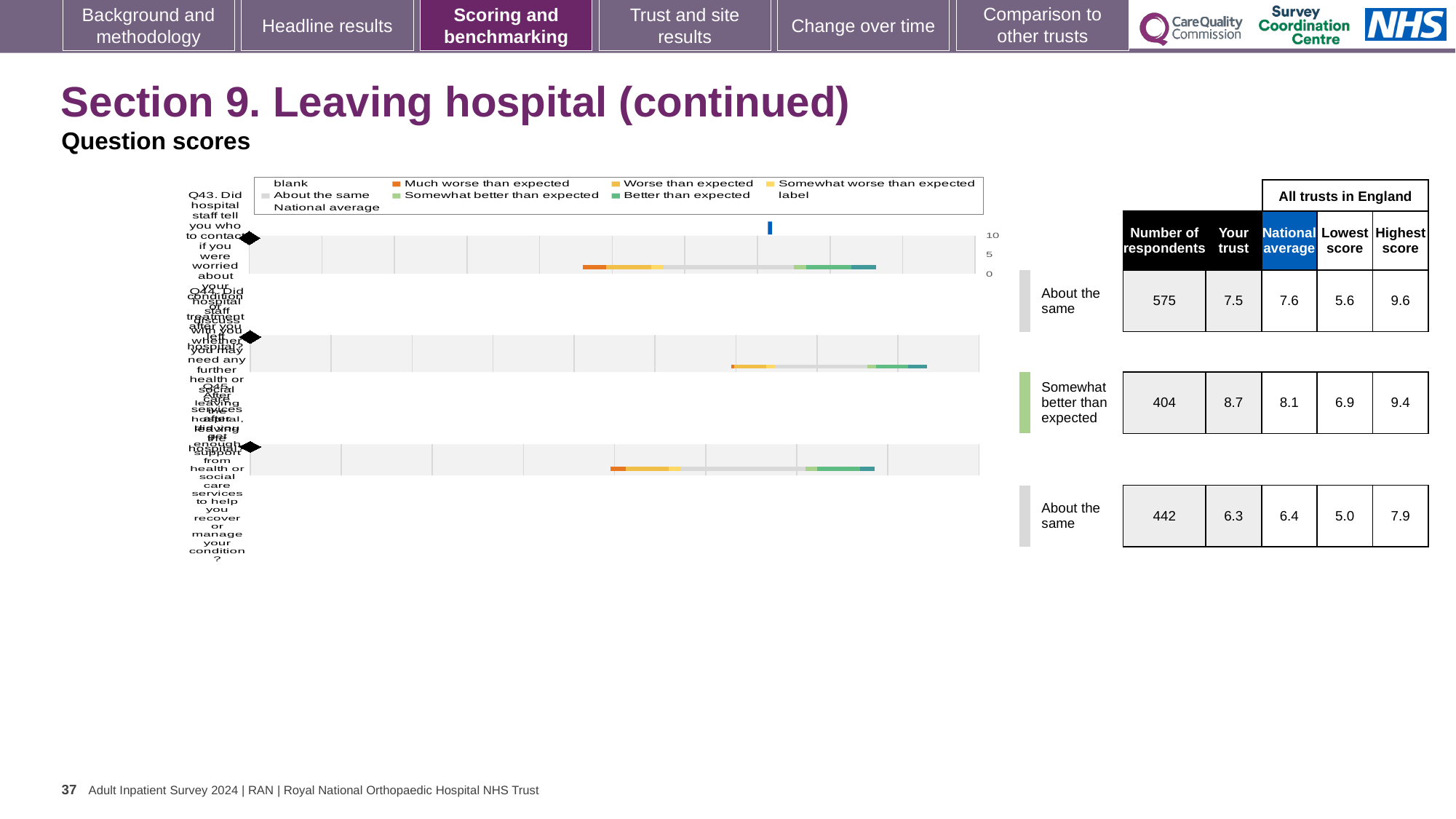
How many questions (bars) are plotted in the chart? 3 What is the difference between the trust score and the national average for Q44? 0.6 Which question has the lowest 'Your trust' score? Q45 For Q43, which is larger: the trust score or the national average? national average What is the highest score across all trusts in England for Q43? 9.6 How many respondents answered Q45 (After leaving hospital, did you get enough support from health or social care services)? 442 What is the national average score for Q44 (Did hospital staff discuss with you whether you may need any further health or social care services after leaving hospital)? 8.1 What is the 'Your trust' score for Q43 (Did hospital staff tell you who to contact if you were worried about your condition or treatment after you left hospital)? 7.5 Which question has the highest 'Your trust' score? Q44 Which benchmark category is Q44 placed in? Somewhat better than expected What kind of chart is shown on the slide? bar chart Is the trust score for Q45 greater or less than 5? greater